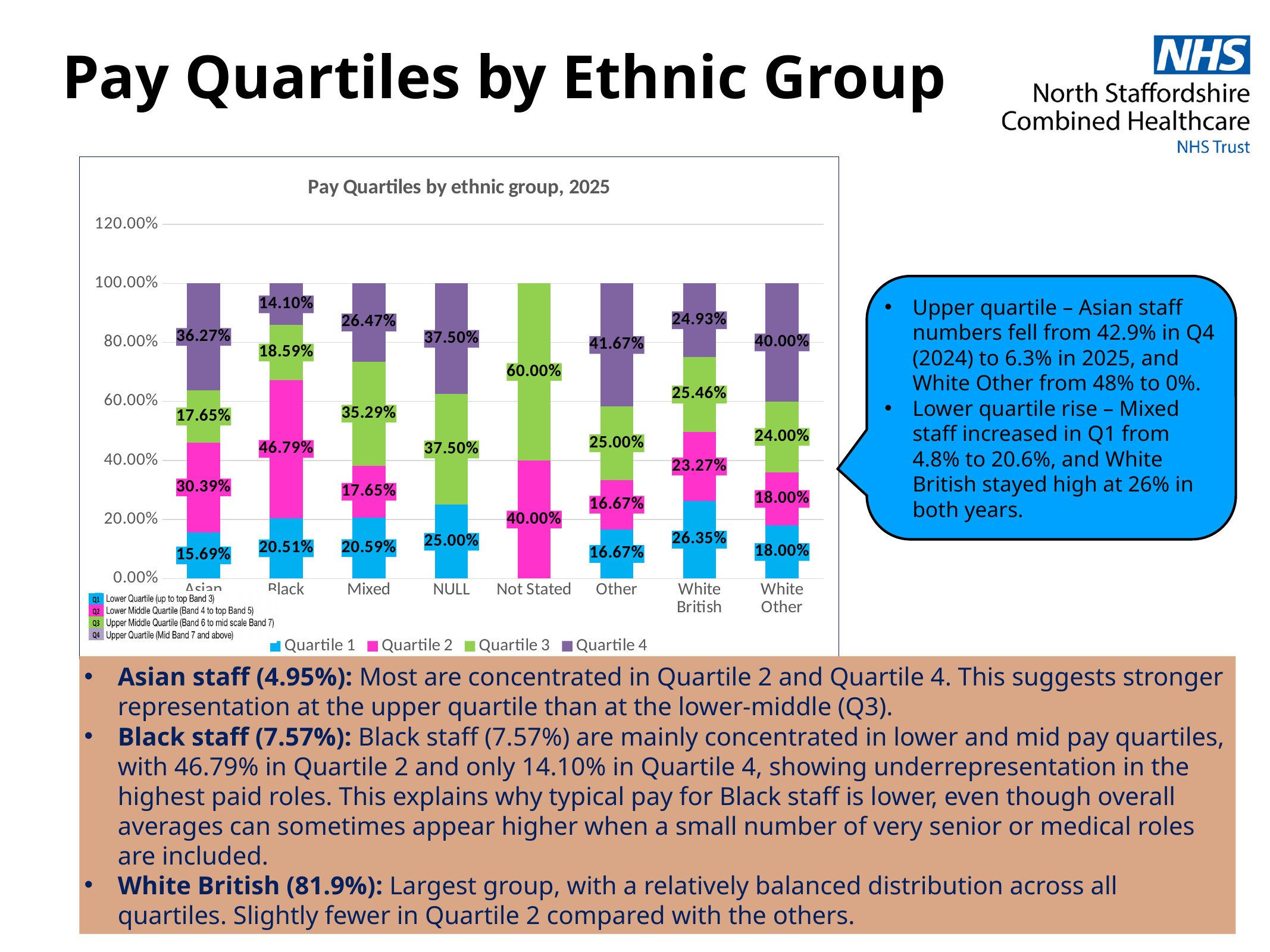
How many series does the legend list? 4 Among the groups with a Quartile 4 label, which has the lowest Quartile 4 value? Black What is the Quartile 3 value for Not Stated? 60.00% What kind of chart is shown? Stacked bar chart What is the Quartile 2 value for Black staff? 46.79% What is the Quartile 4 value for Asian staff? 36.27% What is the title of the chart? Pay Quartiles by ethnic group, 2025 How many ethnic group categories are shown on the x axis? 8 Which is larger: the Quartile 3 value for Mixed or the Quartile 3 value for Asian? Mixed What is the Quartile 1 value for White British staff? 26.35% Which ethnic group has the highest Quartile 2 value? Black What is the difference between the Quartile 4 values for Other and White Other? 1.67%